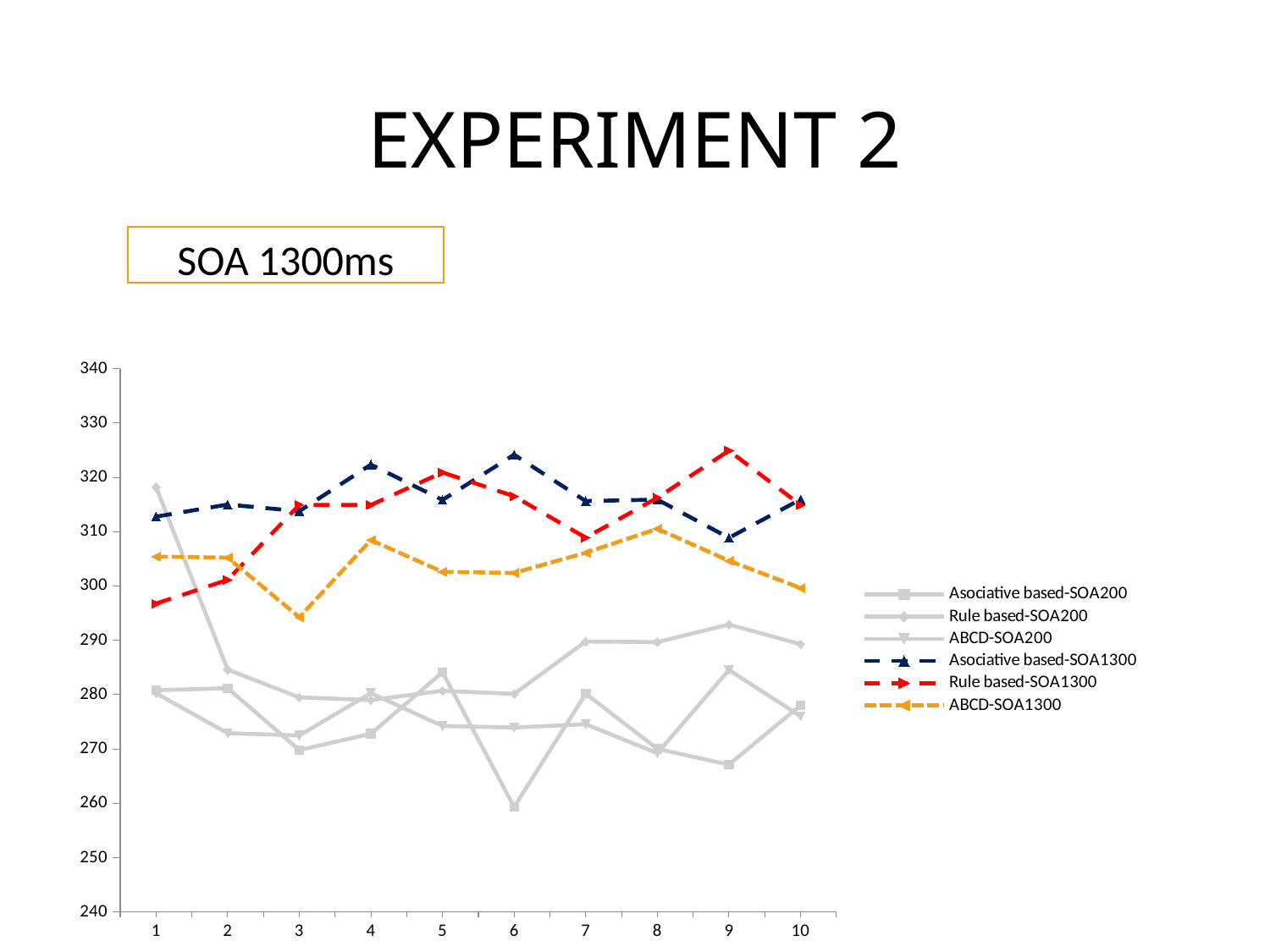
What kind of chart is shown on the slide? line chart At which x-axis point does Rule based-SOA1300 reach its highest value? 9 At point 1, which is higher: Asociative based-SOA1300 or Rule based-SOA1300? Asociative based-SOA1300 At point 9, which is higher: Rule based-SOA1300 or Asociative based-SOA1300? Rule based-SOA1300 How many points are there along the x axis? 10 At which x-axis point does ABCD-SOA1300 reach its lowest value? 3 Is the value for ABCD-SOA1300 at point 3 greater or less than 300? less How many series does the legend list? 6 What text appears in the box above the chart? SOA 1300ms Is the value for Asociative based-SOA1300 at point 6 greater or less than 320? greater Is the value for Rule based-SOA1300 at point 1 greater or less than 300? less